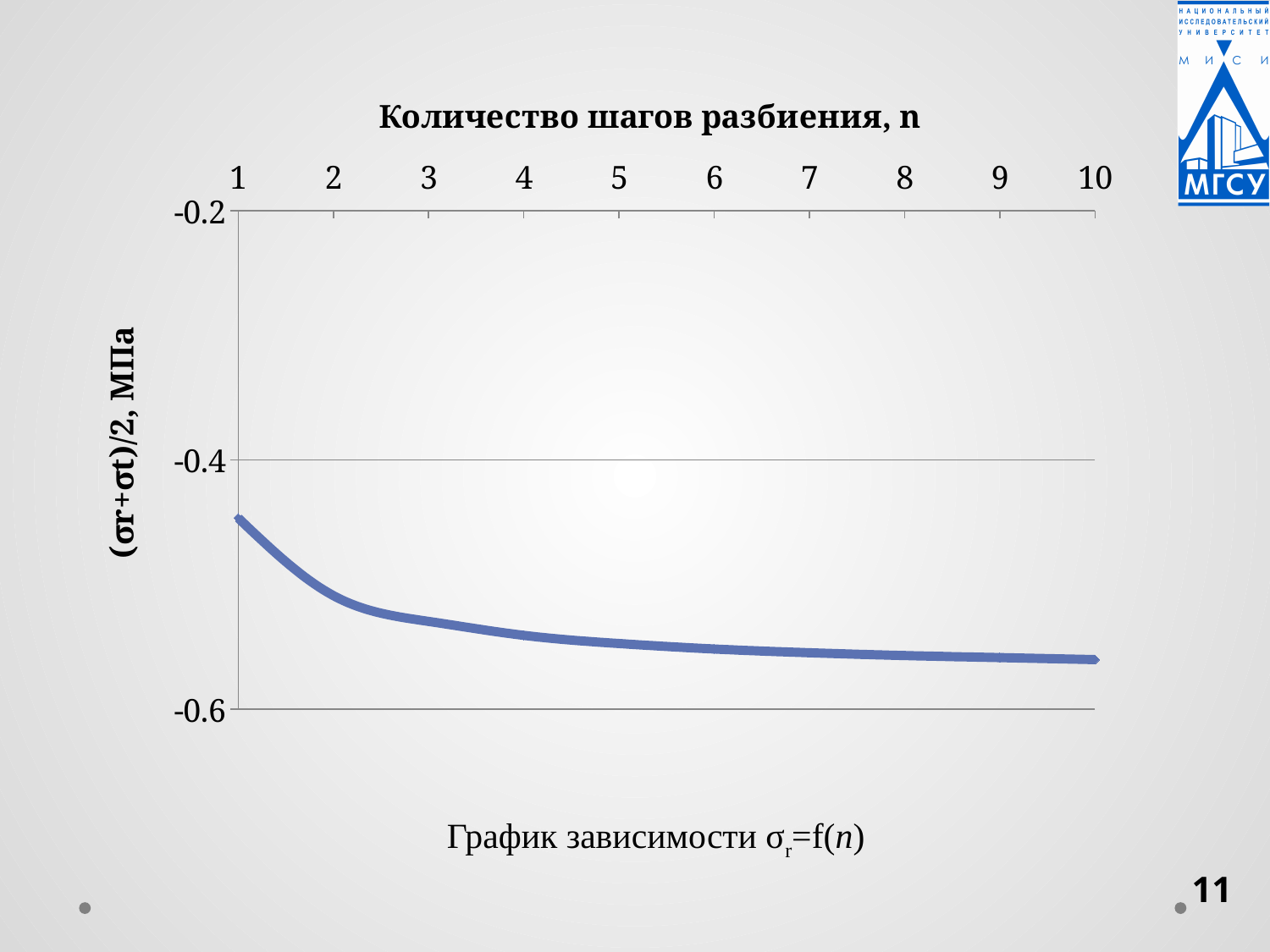
How many values of n are marked on the x axis? 10 Which is larger, the value at n = 1 or the value at n = 3? n = 1 Is the value at n = 5 greater or less than -0.4? less At which value of n is the plotted value highest? 1 Do the values rise or fall as n increases from 1 to 10? fall What is the lowest value labelled on the y axis? -0.6 What is the title of the x axis of the chart? Количество шагов разбиения, n What is the title of the y axis of the chart? (σr+σt)/2, МПа Is the value at n = 1 greater or less than -0.4? less Is the value at n = 10 greater or less than -0.6? greater Which is larger, the value at n = 2 or the value at n = 8? n = 2 What kind of chart is shown on the slide? line chart